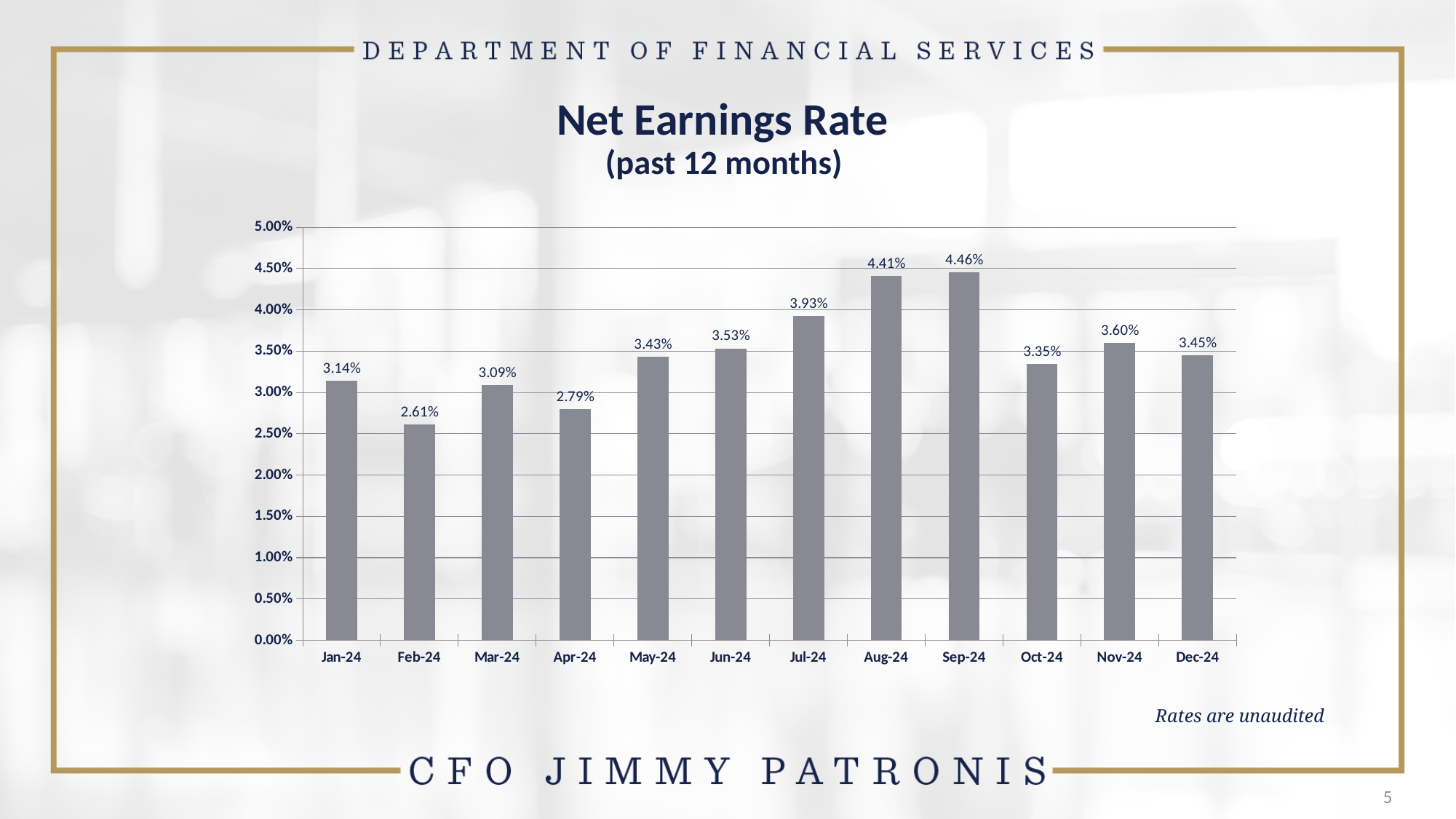
What is the difference between the net earnings rate in Nov-24 and Oct-24? 0.25% What kind of chart is used to show the net earnings rate? bar chart Which month has the highest net earnings rate? Sep-24 Is the net earnings rate for Apr-24 greater or less than 3.00%? less How many months are shown on the chart? 12 What is the net earnings rate for Jul-24? 3.93% Which month has the lowest net earnings rate? Feb-24 Which month has a higher net earnings rate, Jan-24 or Mar-24? Jan-24 Does the net earnings rate rise or fall from Apr-24 to Sep-24? rise What is the net earnings rate for Feb-24? 2.61% What is the difference between the net earnings rate in Sep-24 and Feb-24? 1.85% What is the net earnings rate for Sep-24? 4.46%